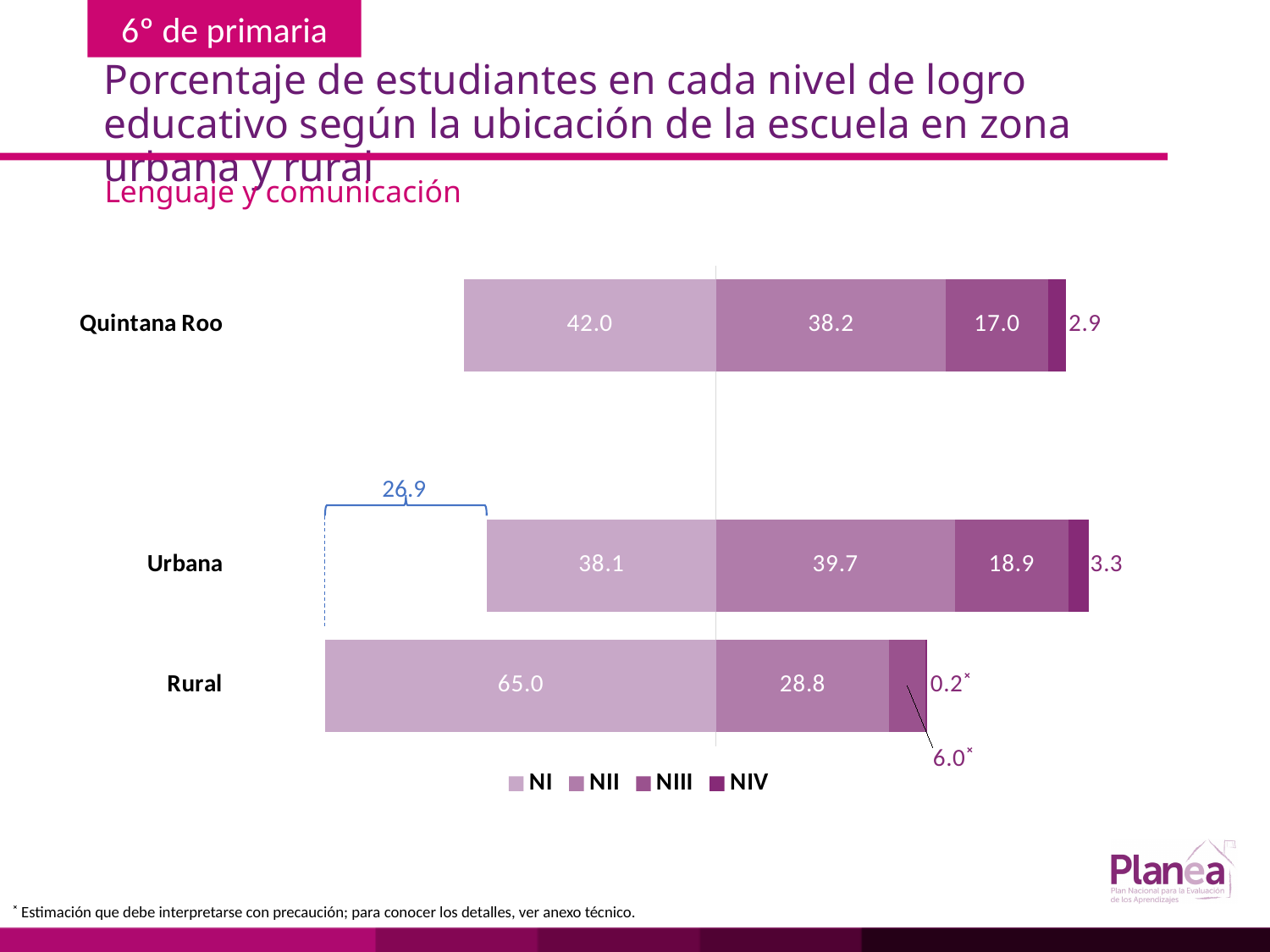
What is the difference between the NI values for Rural and Urbana? 26.9 What is the NIII value for Rural? 6.0 Which is larger, the NIII value for Quintana Roo or the NIII value for Urbana? Urbana How many series does the legend list? 4 What is the NI value for Quintana Roo? 42.0 Which category has the lowest NIV value? Rural What is the NIV value for Urbana? 3.3 What is the subtitle shown above the chart indicating the subject area? Lenguaje y comunicación How many categories (bars) are plotted in the chart? 3 What is the NII value for Urbana? 39.7 What type of chart is shown on the slide? stacked bar chart Which category has the highest NI value? Rural